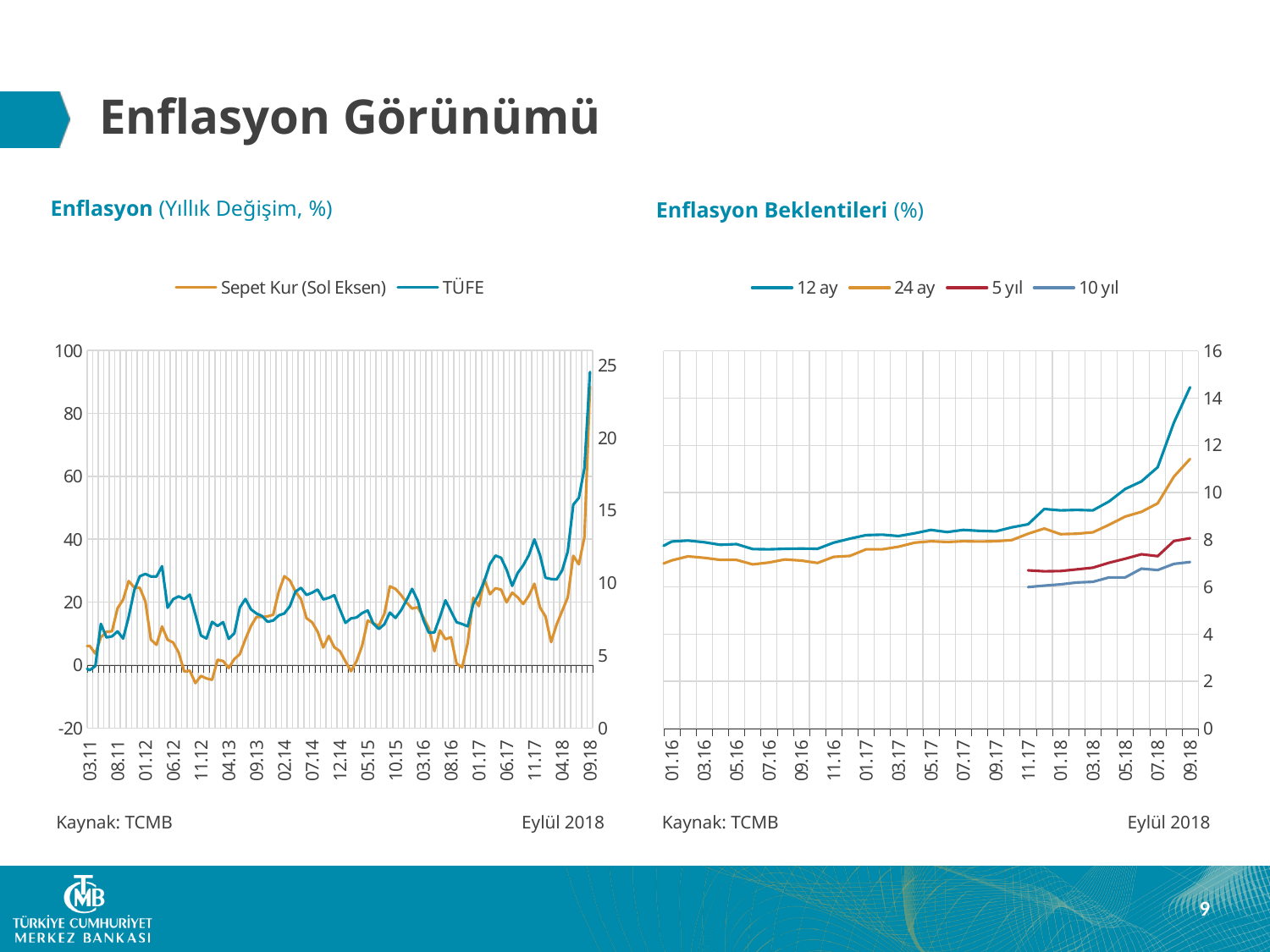
In the right chart 'Enflasyon Beklentileri (%)', is the 24 ay value at 09.18 greater or less than 10? greater What kind of chart is the 'Enflasyon Beklentileri (%)' chart on the right? line chart In the left chart 'Enflasyon (Yıllık Değişim, %)', is the Sepet Kur (Sol Eksen) value at 09.18 greater or less than 80 on the left axis? greater In the right chart 'Enflasyon Beklentileri (%)', does the 12 ay series rise or fall overall from 01.16 to 09.18? rise How many series does the legend of the left chart 'Enflasyon (Yıllık Değişim, %)' list? 2 In the right chart 'Enflasyon Beklentileri (%)', is the 12 ay value at 09.18 greater or less than 12? greater What kind of chart is the 'Enflasyon (Yıllık Değişim, %)' chart on the left? line chart How many series does the legend of the right chart 'Enflasyon Beklentileri (%)' list? 4 What source is cited below both charts on the slide? Kaynak: TCMB